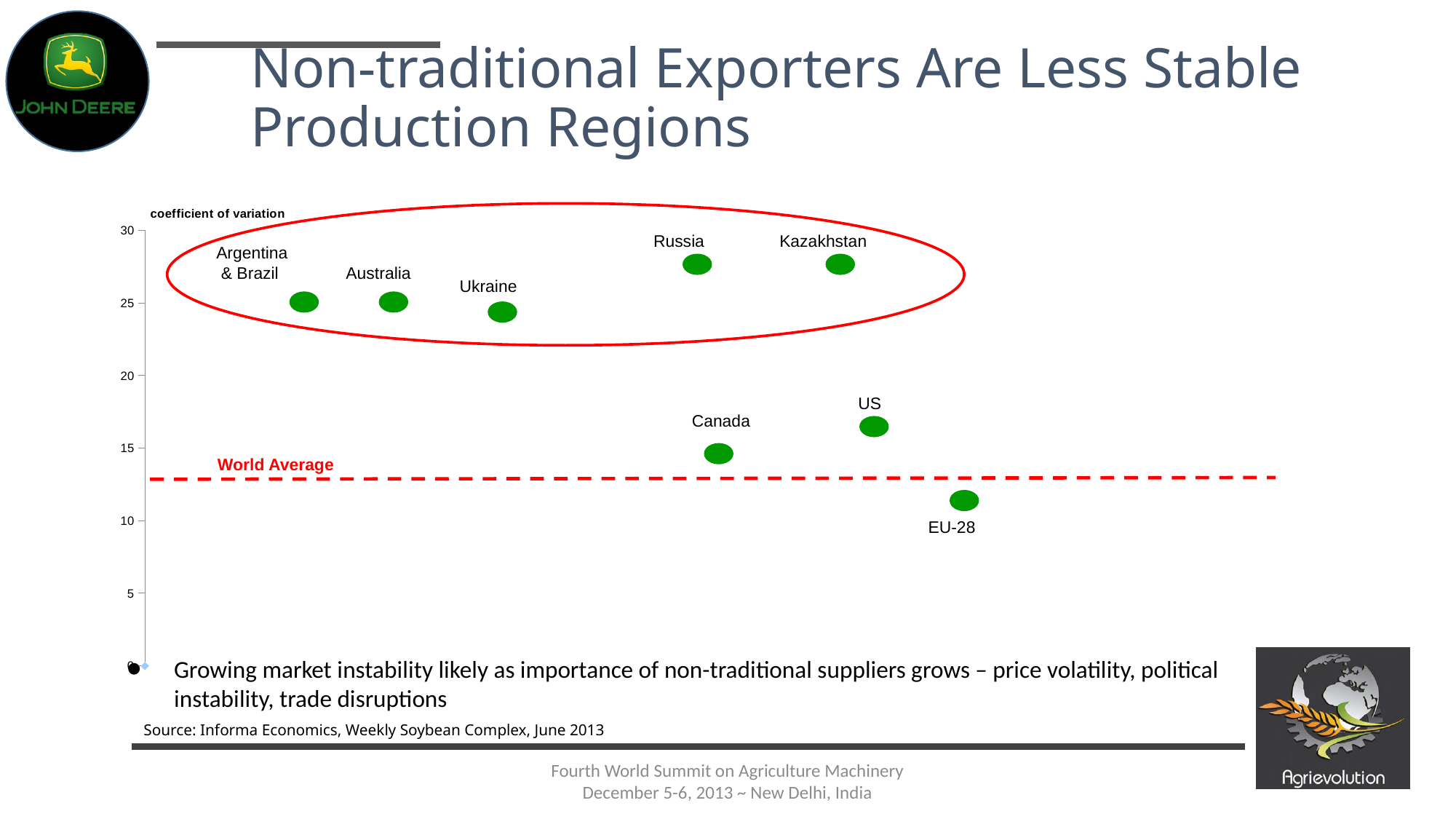
Is the coefficient of variation for the US greater or less than 15? greater What kind of chart is shown on the slide? scatter chart What does the red dashed horizontal line on the chart represent? World Average Which has the higher coefficient of variation, the US or Canada? US Which has the lower coefficient of variation, Canada or EU-28? EU-28 What quantity does the vertical axis of the chart measure? coefficient of variation Which has the higher coefficient of variation, Russia or Ukraine? Russia How many labelled data points are plotted on the chart? 8 Which region has the lowest coefficient of variation on the chart? EU-28 Is the coefficient of variation for Argentina & Brazil greater or less than 20? greater Is the coefficient of variation for Russia greater or less than 25? greater